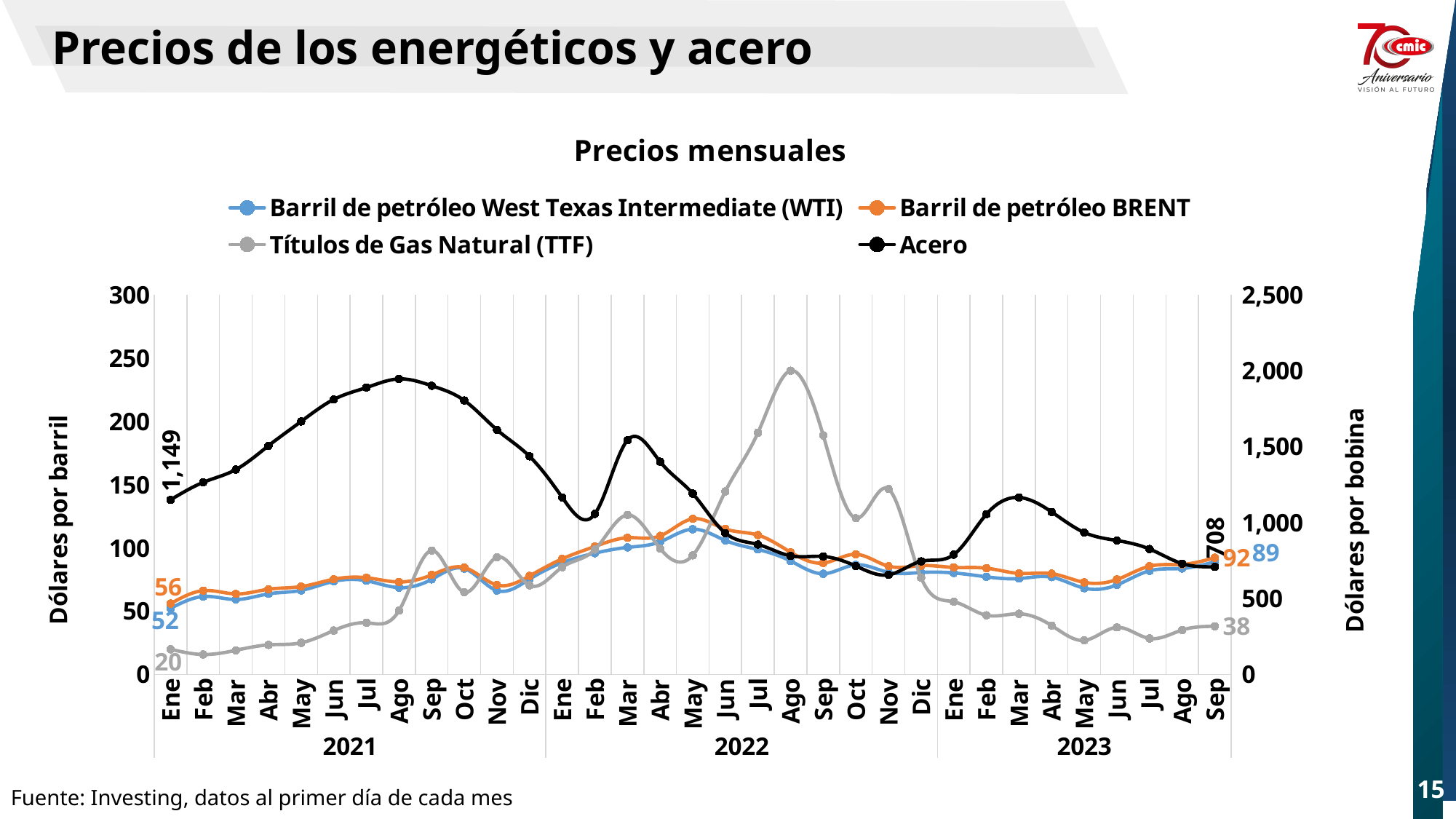
By how much did the WTI value change from Ene 2021 (52) to Sep 2023 (89)? 37 What is the value for Acero in Ene 2021? 1,149 What is the value for Barril de petróleo West Texas Intermediate (WTI) in Ene 2021? 52 What kind of chart is shown on the slide? line chart In Ene 2021, which is larger: the BRENT value or the WTI value? BRENT What is the value for Barril de petróleo BRENT in Sep 2023? 92 How many series does the legend list? 4 What is the title of the right-hand vertical axis? Dólares por bobina Is the value for Acero in Ago 2021 greater or less than 1,500? greater Is the value for Títulos de Gas Natural (TTF) in Ago 2022 greater or less than 200? greater What is the value for Títulos de Gas Natural (TTF) in Sep 2023? 38 What is the difference between the Acero value in Ene 2021 and in Sep 2023? 441